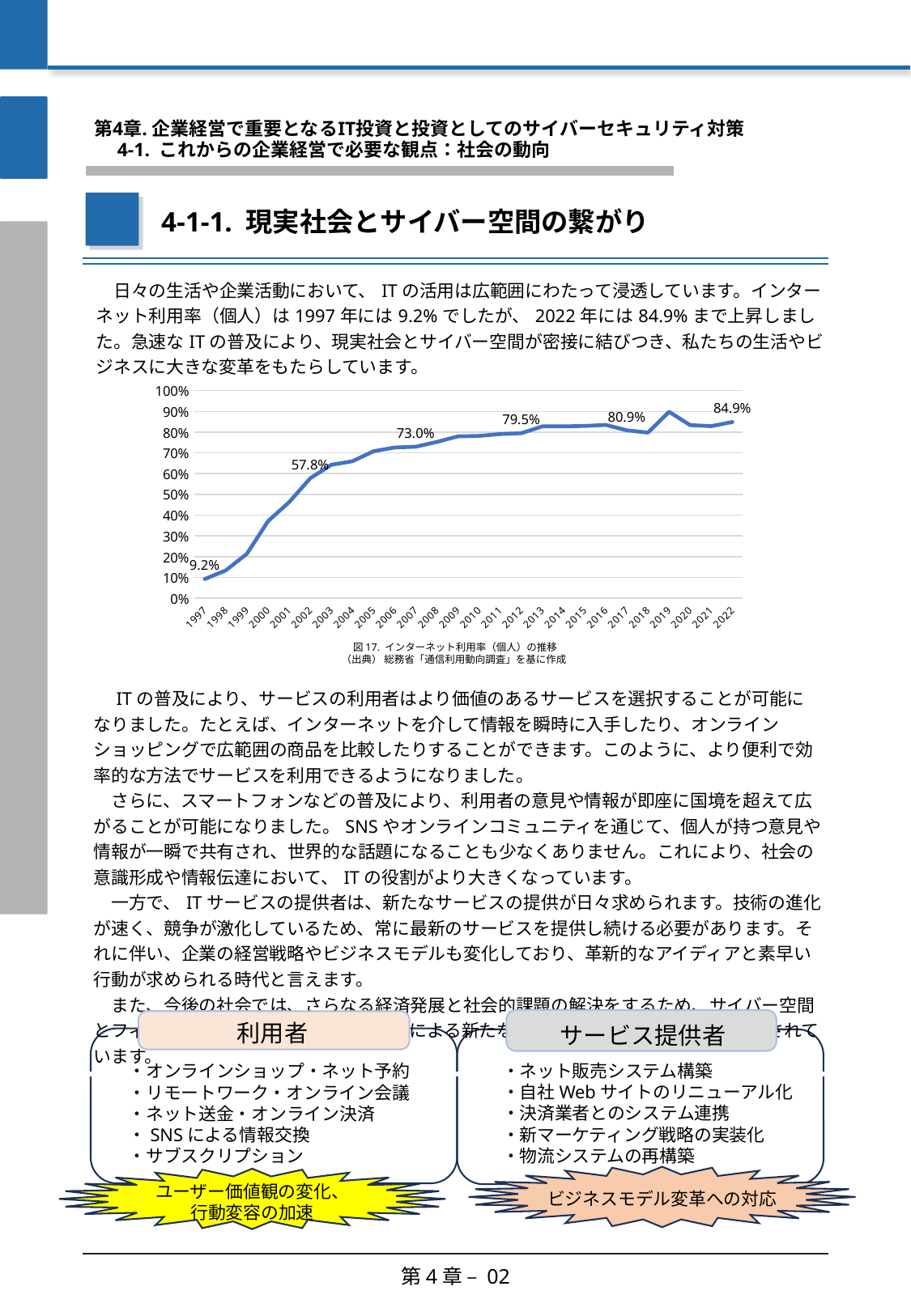
Is the value for 1998 greater or less than 20%? less What type of chart is shown on the slide? Line chart What is the internet usage rate shown for 2022? 84.9% What is the internet usage rate shown for 2007? 73.0% What is the internet usage rate shown for 2002? 57.8% What is the overall trend of the internet usage rate from 1997 to 2022? Rising How many years are plotted on the x axis of the chart? 26 What is the internet usage rate shown for 1997? 9.2% Is the value for 2019 greater or less than 80%? greater Which year has the lowest internet usage rate in the chart? 1997 Which is larger, the value for 2002 or the value for 2007? 2007 By how many percentage points did the internet usage rate increase from 1997 to 2022? 75.7 percentage points